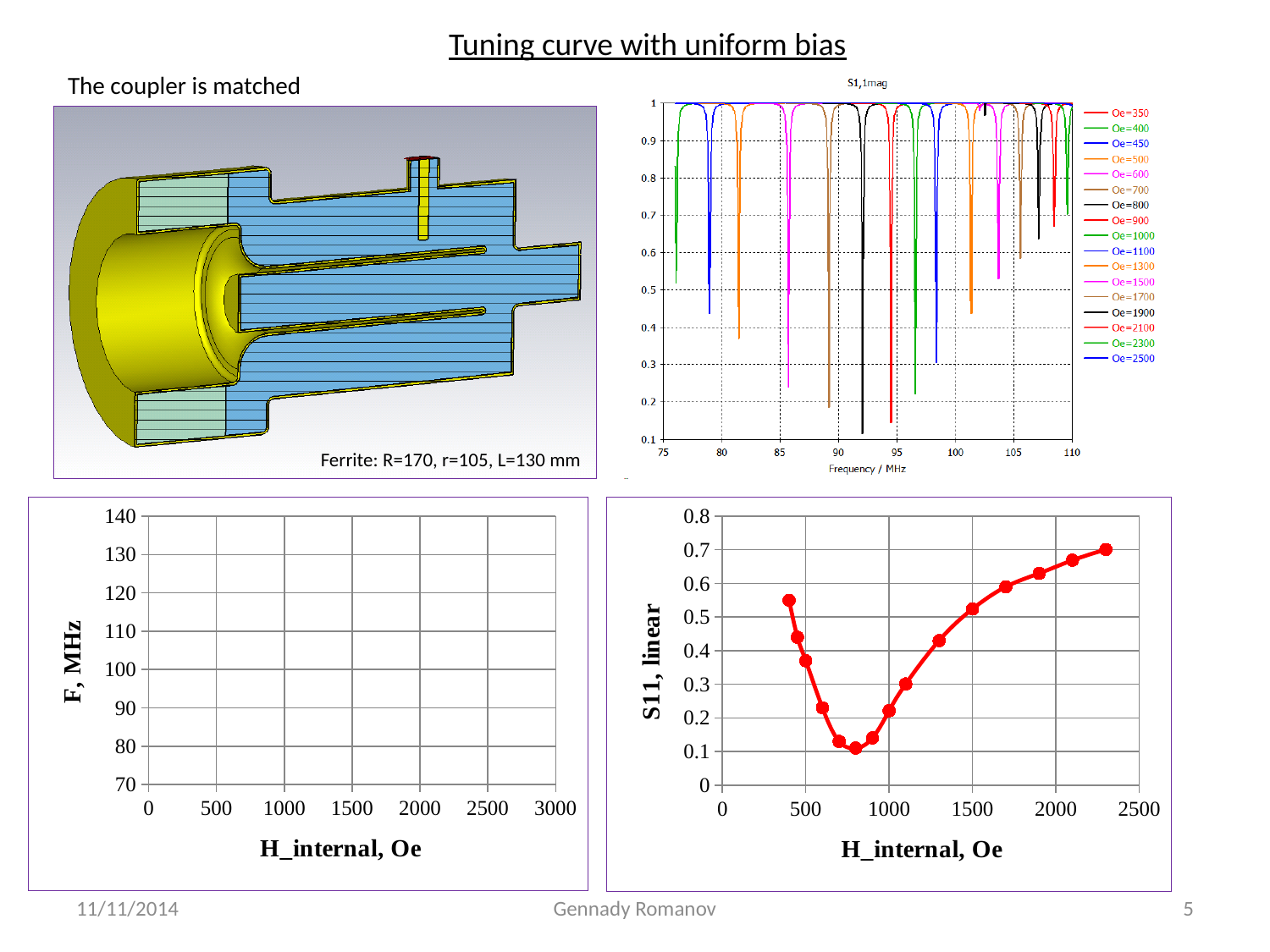
What kind of chart is the bottom-right chart (S11, linear vs H_internal, Oe)? line chart How many series does the legend of the top-right chart (S1,1mag) list? 17 In the bottom-right chart (S11, linear vs H_internal, Oe), is the value at H_internal = 800 Oe greater or less than 0.2? less In the bottom-right chart (S11, linear vs H_internal, Oe), is the value at H_internal = 2300 Oe greater or less than 0.6? greater What is the y-axis label of the bottom-left chart? F, MHz In the bottom-right chart (S11, linear vs H_internal, Oe), does S11 rise or fall as H_internal increases from 1000 Oe to 2300 Oe? rise In the bottom-right chart (S11, linear vs H_internal, Oe), does S11 rise or fall as H_internal increases from 400 Oe to 800 Oe? fall In the top-right chart (S1,1mag), is the lowest point of the Oe=800 curve greater or less than 0.2? less What is the x-axis label of the top-right chart (S1,1mag)? Frequency / MHz In the bottom-right chart (S11, linear vs H_internal, Oe), which is larger: the value at H_internal = 500 Oe or the value at H_internal = 2100 Oe? 2100 Oe